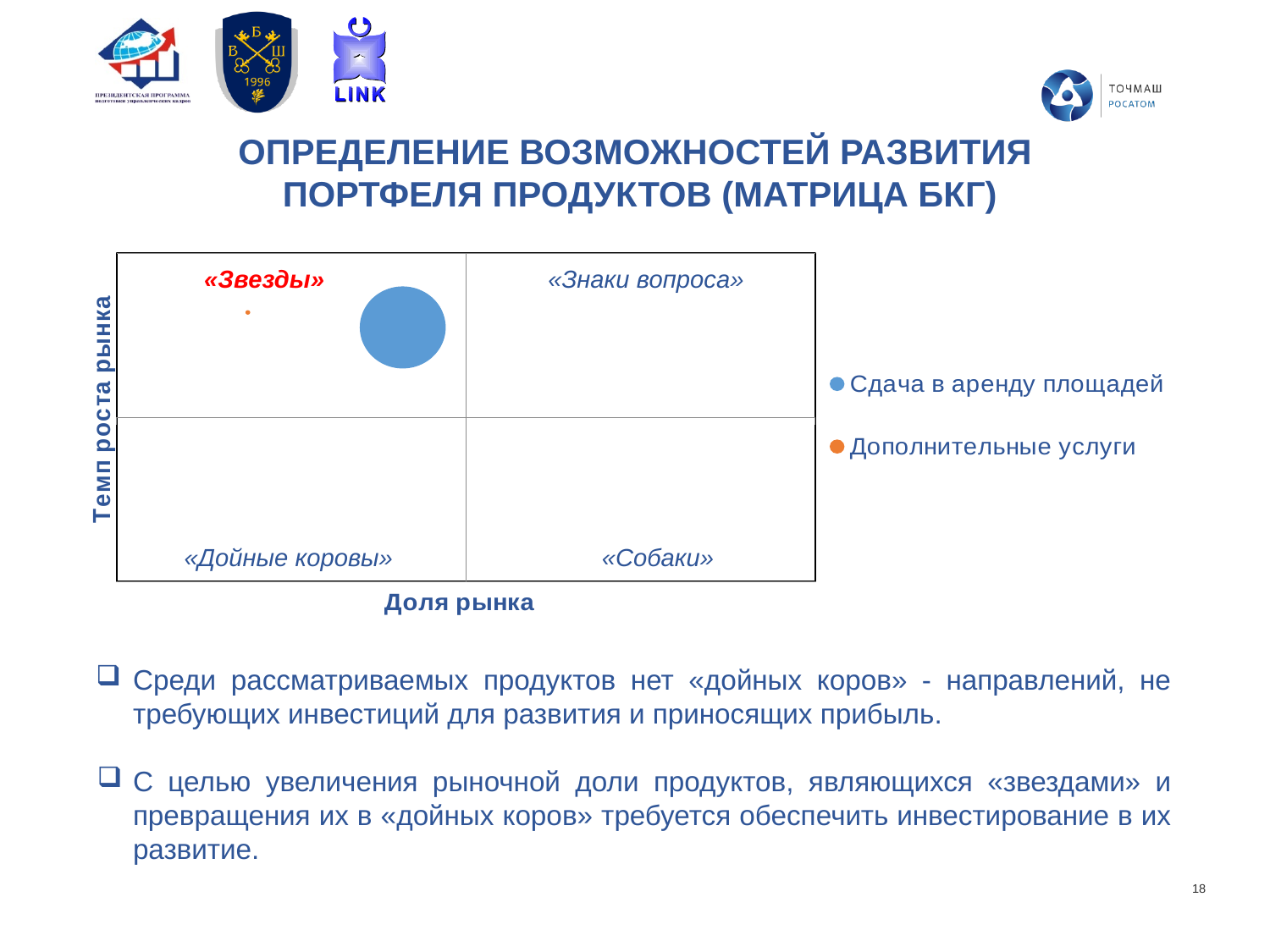
Which series is drawn with the larger bubble, «Сдача в аренду площадей» or «Дополнительные услуги»? Сдача в аренду площадей How many bubbles are plotted in the «Дойные коровы» quadrant? 0 How many bubbles are plotted in the «Звезды» quadrant? 2 In which quadrant of the matrix is the bubble for «Сдача в аренду площадей» located? «Звезды» How many series does the legend of the BCG matrix chart list? 2 In which quadrant of the matrix is the bubble for «Дополнительные услуги» located? «Звезды» What kind of chart is shown on the slide? bubble chart What is the label of the vertical axis of the chart? Темп роста рынка How many quadrants does the matrix chart have? 4 What is the label of the horizontal axis of the chart? Доля рынка